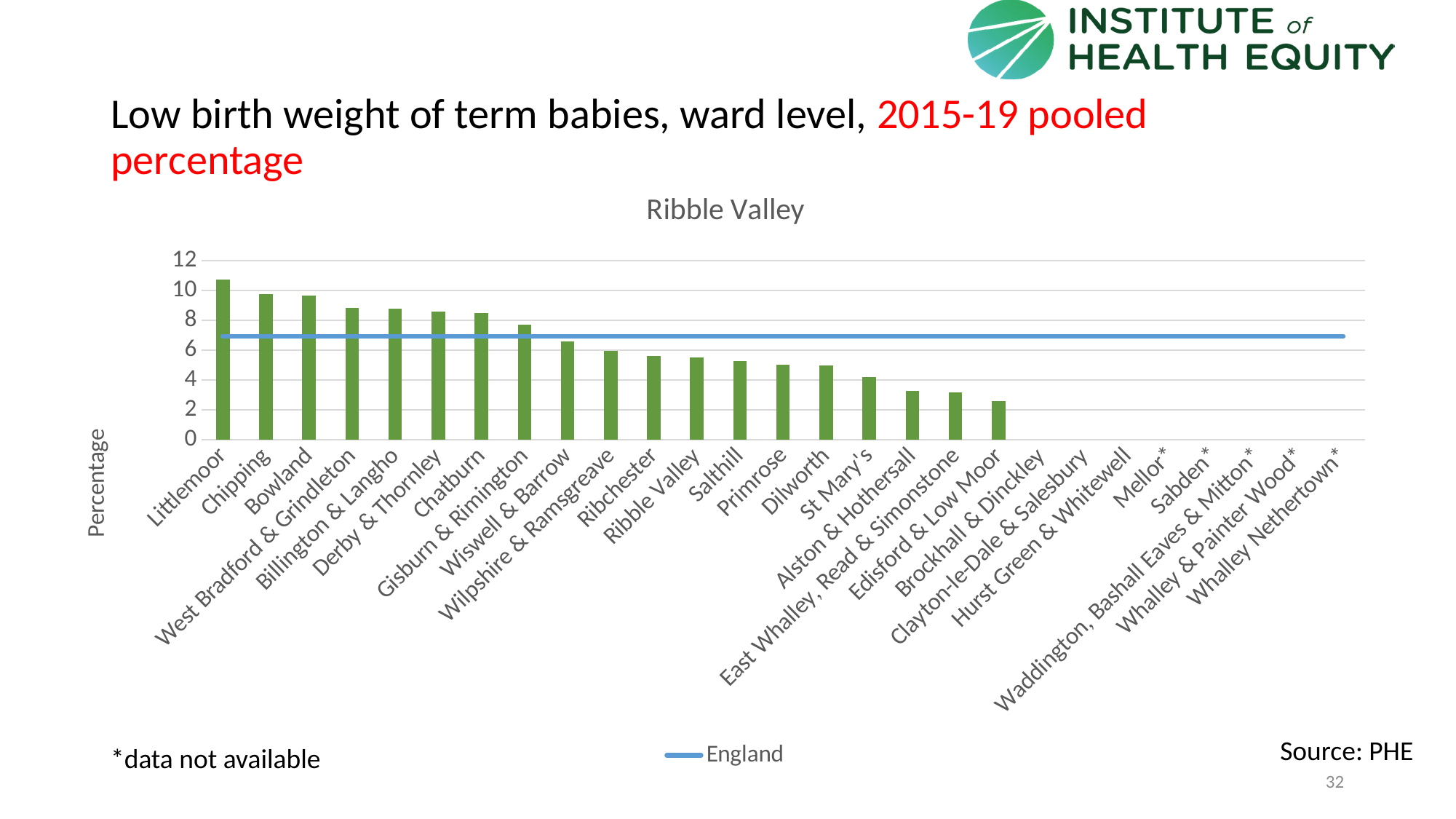
Is the value for Chipping greater or less than 8? greater What kind of chart is shown on the slide? Combination bar and line chart (bars for wards with a line for England) Do the bar values rise or fall moving from left to right along the x axis? Fall Is the value for Littlemoor greater or less than 10? greater Which ward has the highest low birth weight percentage in the chart? Littlemoor How many wards are marked with an asterisk indicating data not available? 5 Which is larger, the value for Dilworth or the value for St Mary's? Dilworth Is the value for Wilpshire & Ramsgreave greater or less than 8? less How many series does the legend list? 1 Which is larger, the value for Littlemoor or the value for Chipping? Littlemoor Among the wards with a bar plotted, which has the lowest value? Edisford & Low Moor